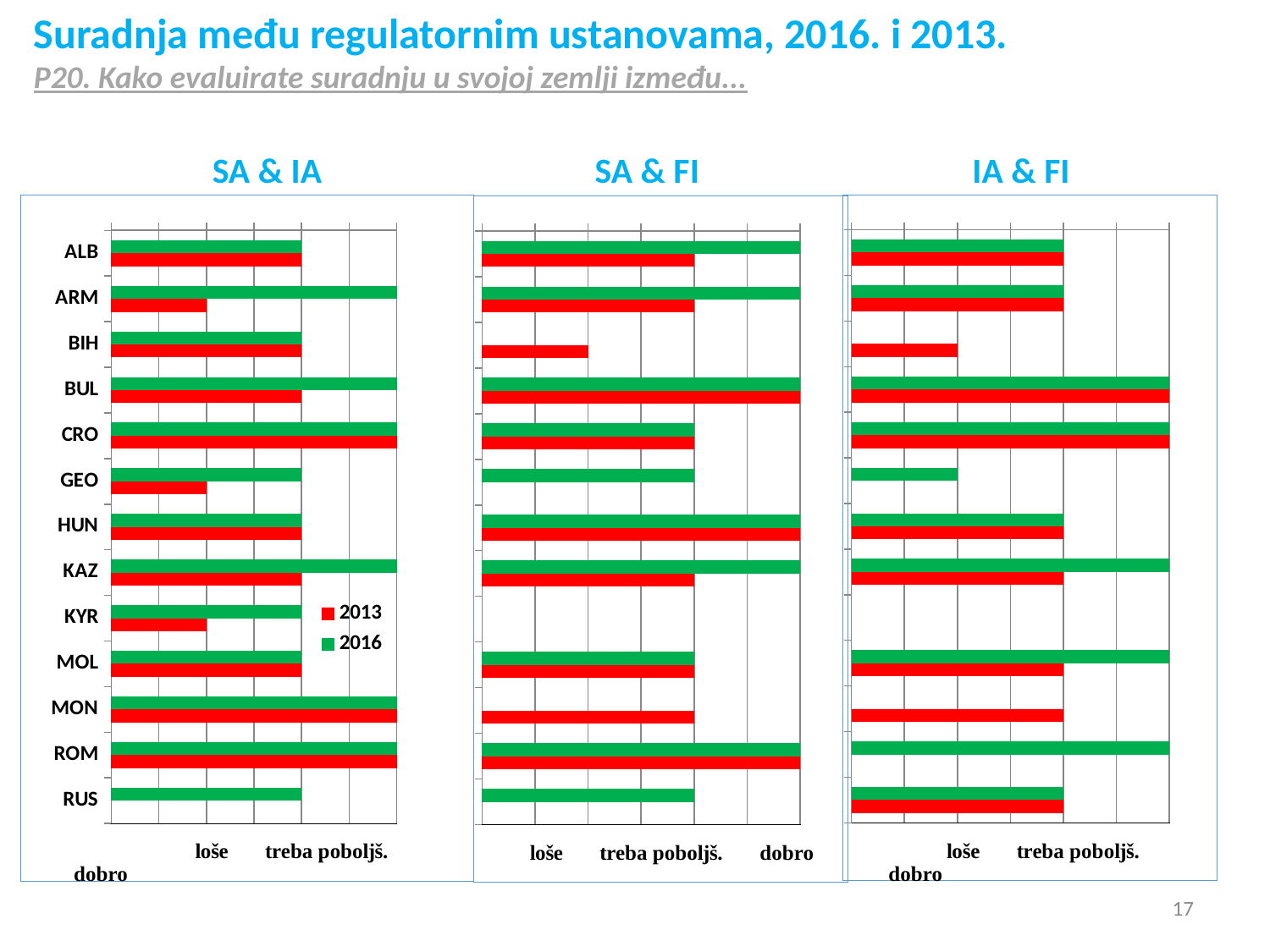
On the "SA & FI" chart, which is longer for BUL, the 2013 bar or the 2016 bar? They are equal On the "SA & IA" chart, which colour represents 2013? red How many bar charts are shown on the slide? 3 What kind of chart is the "SA & IA" chart? bar chart What is the title of the rightmost chart on the slide? IA & FI On the "SA & IA" chart, which is longer for ARM, the 2013 bar or the 2016 bar? 2016 On the "SA & IA" chart, which is longer for KYR, the 2013 bar or the 2016 bar? 2016 How many series does the legend on the "SA & IA" chart list? 2 How many countries are listed on the "SA & IA" chart? 13